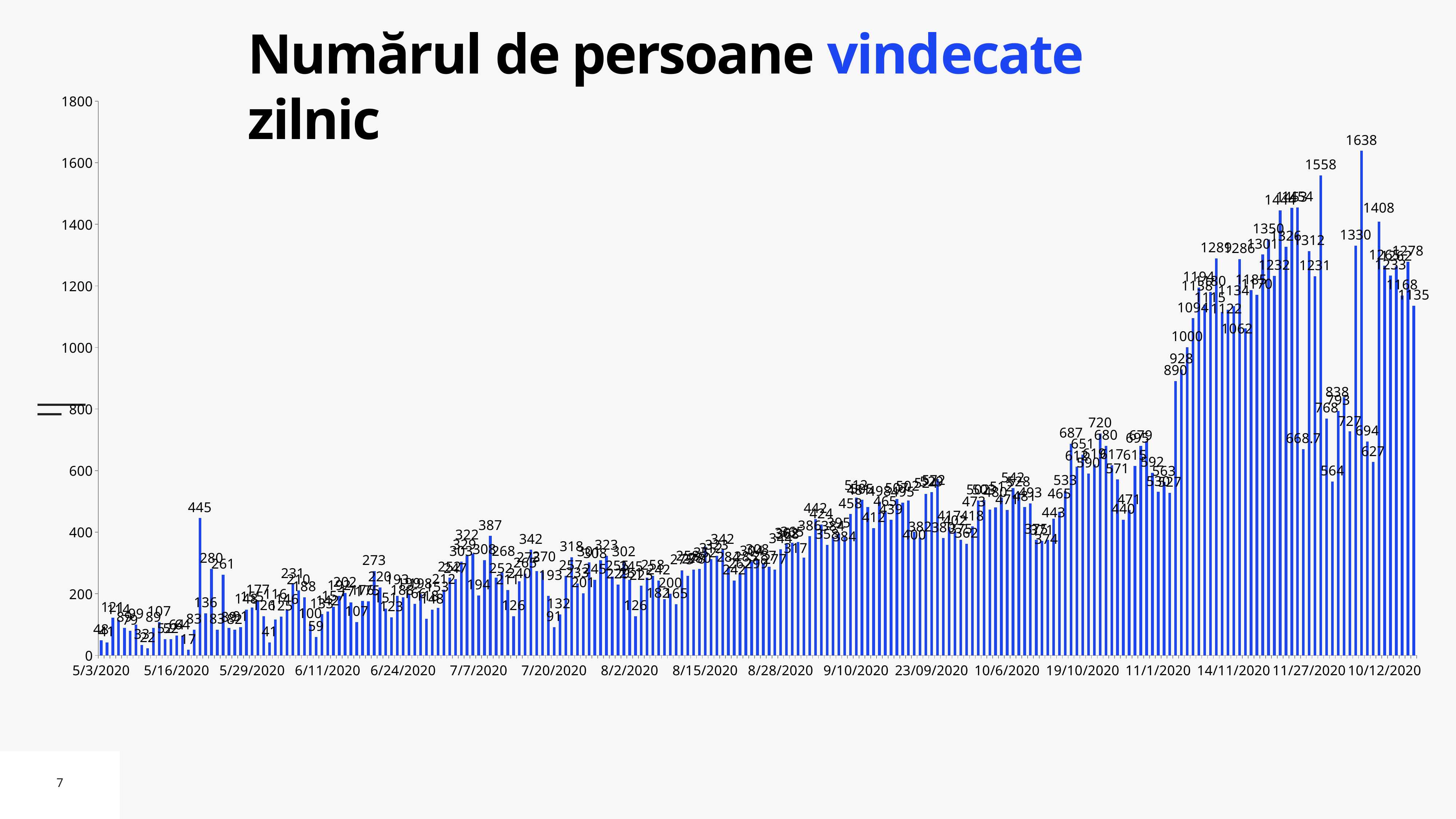
What is the second highest value labelled on the chart? 1558 What is the highest value labelled among the bars in May 2020 (between 5/16/2020 and 5/29/2020)? 445 What is the difference between the two highest labelled values, 1638 and 1558? 80 What is the highest value labelled on the chart? 1638 Overall, do the values rise or fall from left to right along the x axis? rise Which is larger, the bar labelled 1638 or the bar labelled 1558? 1638 Is the value of the tallest bar greater or less than 1600? greater What is the maximum value shown on the y axis? 1800 What is the value labelled on the last bar of the chart? 1135 Is the value of the first bar (5/3/2020) greater or less than 200? less What is the title of the chart? Numărul de persoane vindecate zilnic What kind of chart is shown on the slide? bar chart